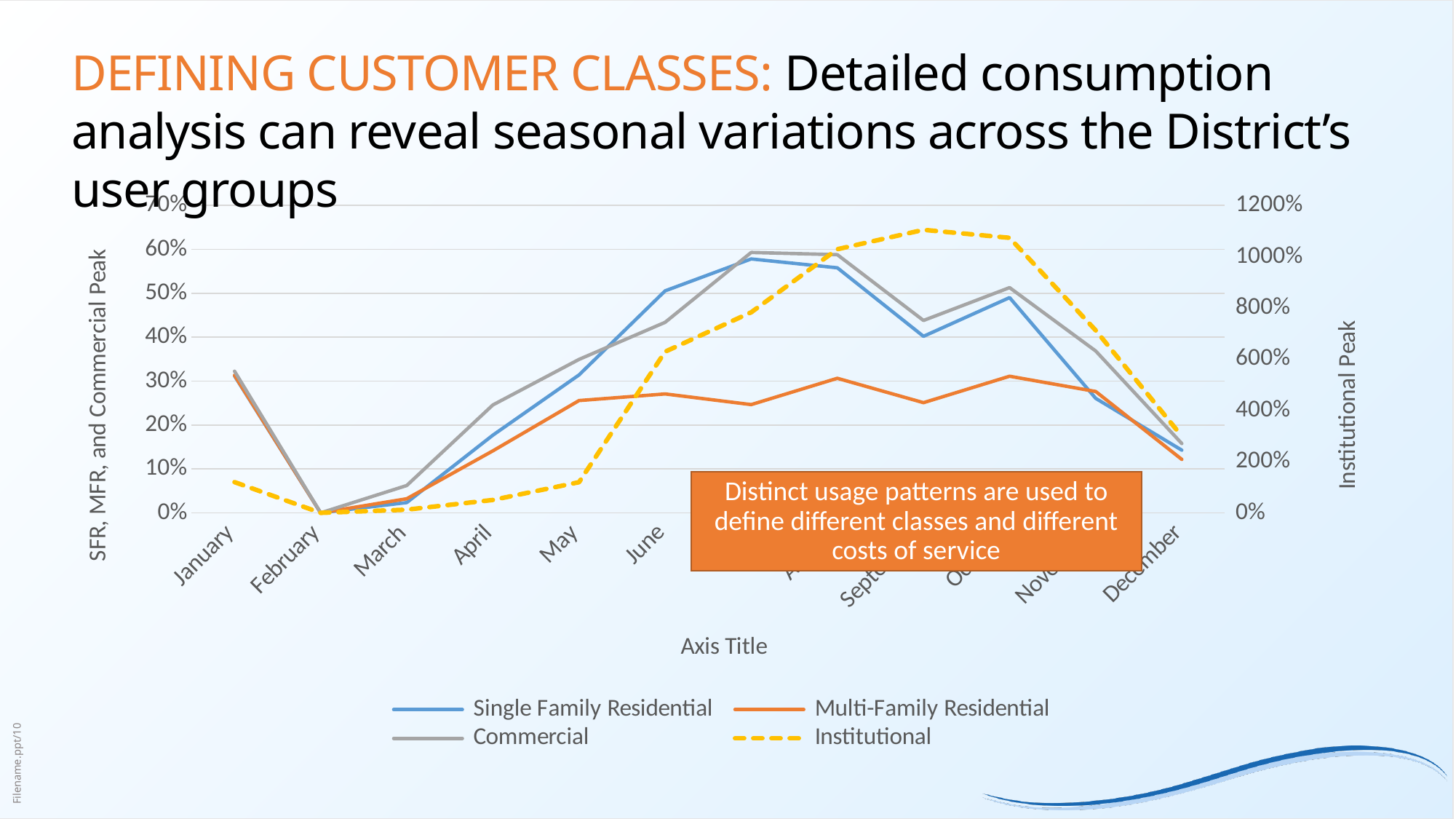
In June, which is higher: Single Family Residential or Multi-Family Residential? Single Family Residential Is the value for Multi-Family Residential in January greater or less than 20%? greater What is the title of the right-hand vertical axis? Institutional Peak What kind of chart is shown on the slide? line chart How many months are plotted along the x axis? 12 Is the value for Single Family Residential in June greater or less than 40%? greater Which series is drawn with a dashed line? Institutional From February to June, does the Single Family Residential line rise or fall? rise Is the value for Single Family Residential in February greater or less than 10%? less In which month is the Single Family Residential value lowest? February How many series does the legend list? 4